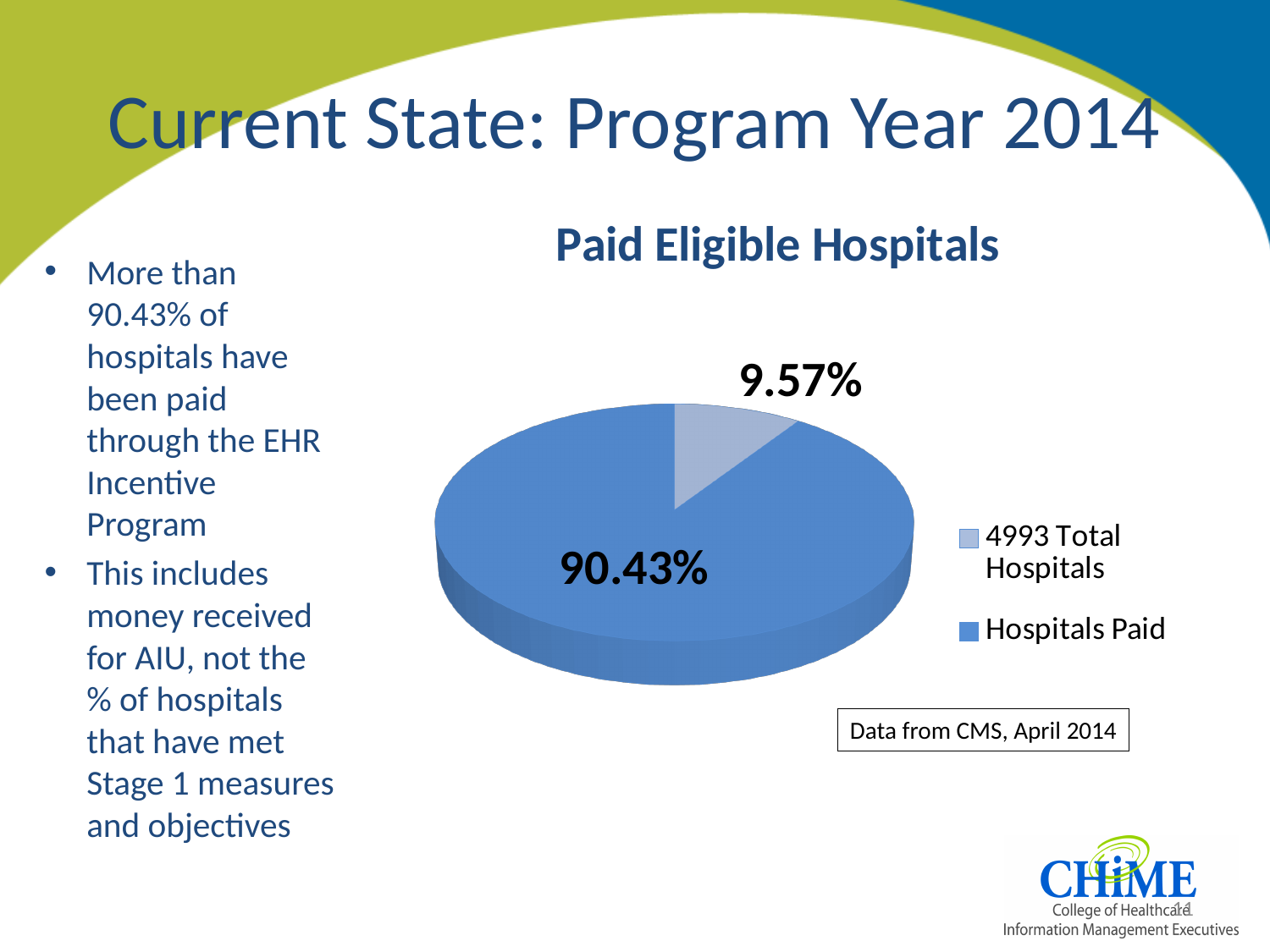
What is the title of the chart? Paid Eligible Hospitals What kind of chart is shown on the slide? pie chart What percentage is shown for the Hospitals Paid slice? 90.43% Which slice of the pie is the largest? Hospitals Paid How many entries does the legend list? 2 What share of the pie does the Hospitals Paid slice represent? 90.43% Which is larger, the Hospitals Paid slice or the 4993 Total Hospitals slice? Hospitals Paid What is the difference in percentage points between the Hospitals Paid slice and the 4993 Total Hospitals slice? 80.86 How many slices does the pie chart have? 2 What percentage is shown for the 4993 Total Hospitals slice? 9.57% What colour is the Hospitals Paid slice in the legend? blue Which slice of the pie is the smallest? 4993 Total Hospitals